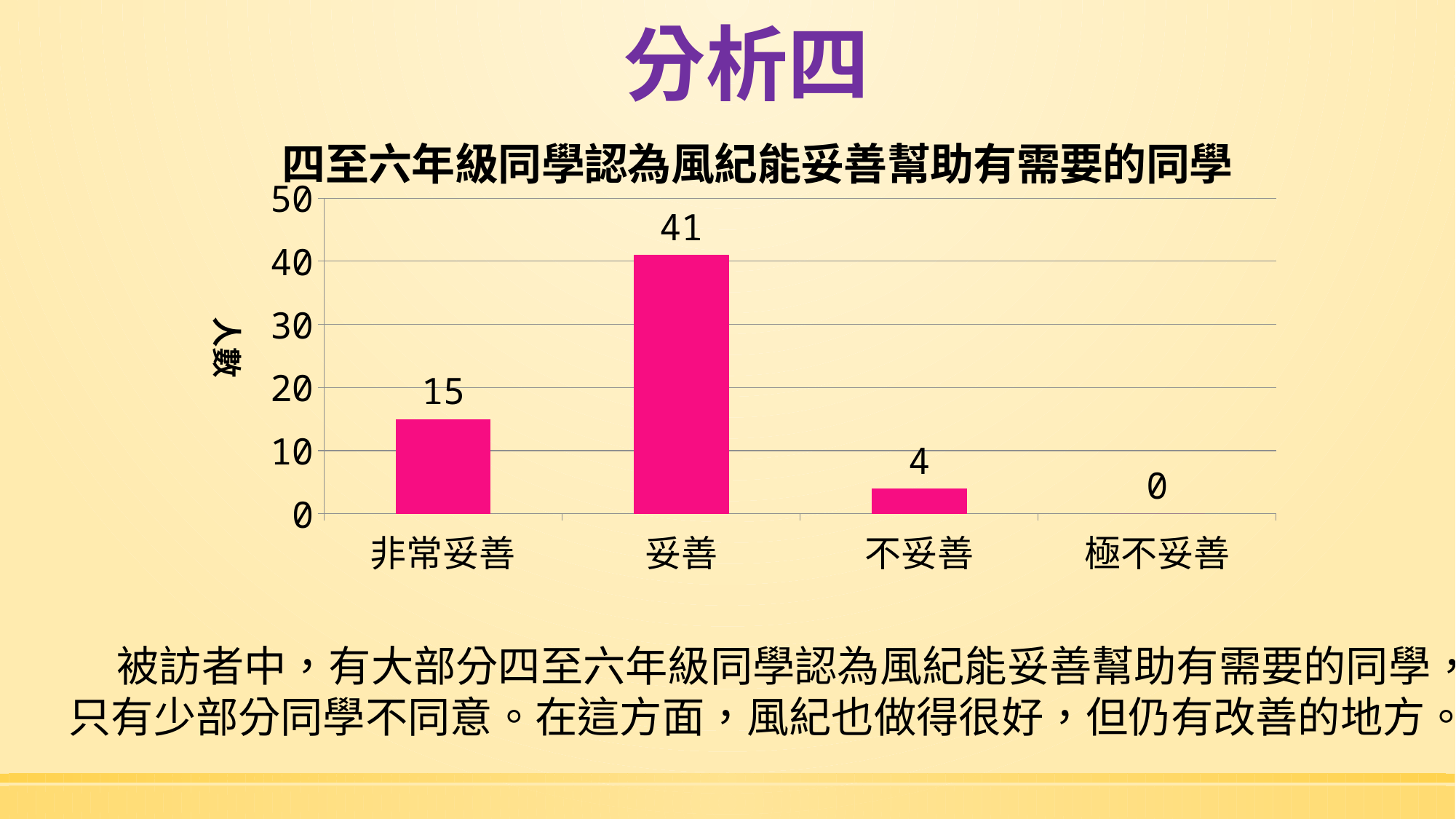
What is the value for 極不妥善? 0 How many categories are shown on the x axis? 4 Which is larger, the value for 非常妥善 or the value for 不妥善? 非常妥善 Which category has the highest value? 妥善 What is the value for 不妥善? 4 Which category has the lowest value? 極不妥善 What is the difference between the values for 妥善 and 非常妥善? 26 What is the value for 非常妥善? 15 What is the value for 妥善? 41 What is the title of the chart? 四至六年級同學認為風紀能妥善幫助有需要的同學 Is the value for 妥善 greater or less than 30? greater What kind of chart is shown on the slide? bar chart